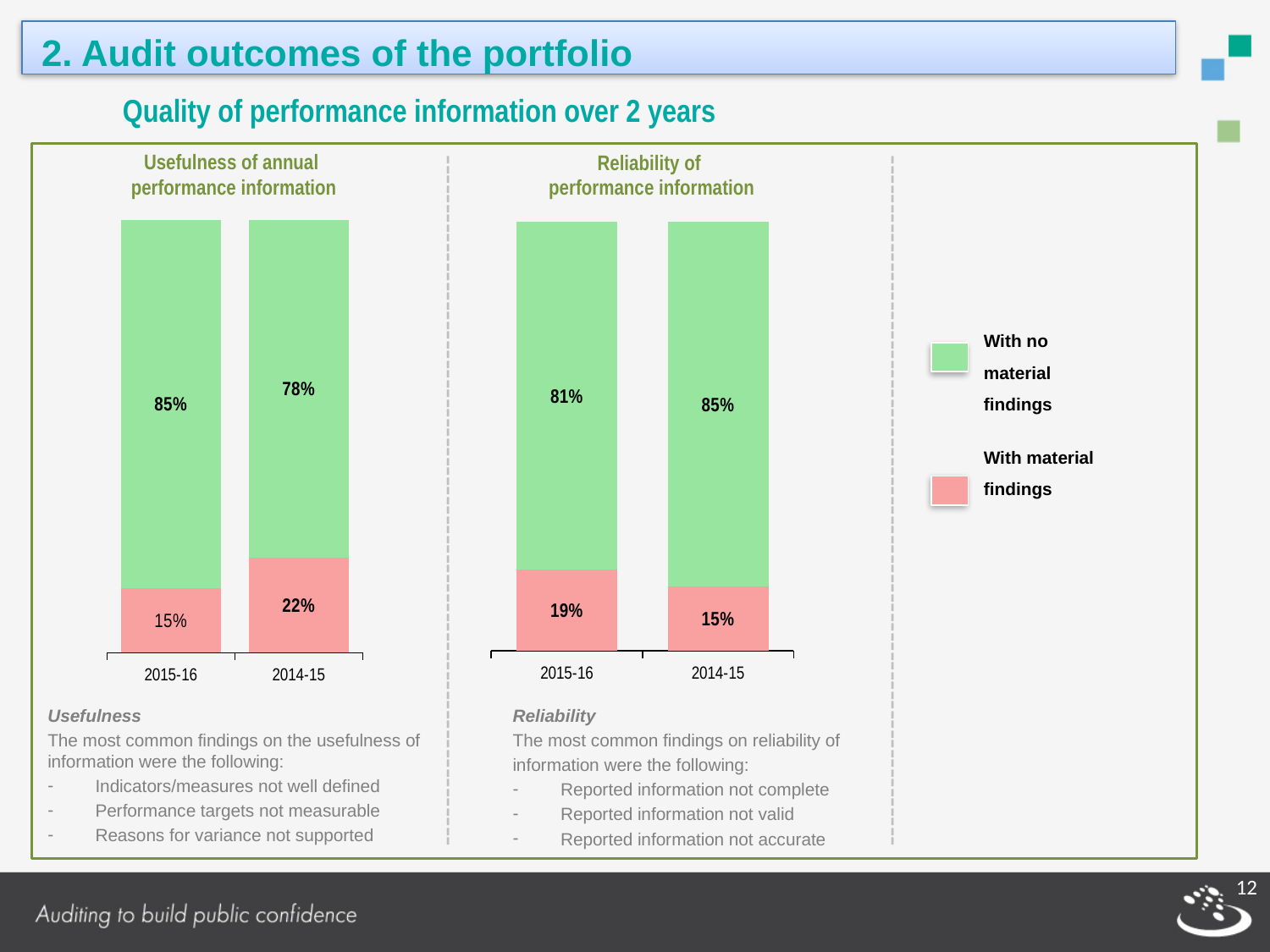
In the 'Usefulness of annual performance information' chart, what is the difference between the 'With no material findings' values for 2015-16 and 2014-15? 7% In the 'Reliability of performance information' chart, what is the difference between the 'With material findings' values for 2015-16 and 2014-15? 4% In the 'Usefulness of annual performance information' chart, which year has the higher share with material findings? 2014-15 In the 'Reliability of performance information' chart, what percentage had material findings in 2014-15? 15% In the 'Usefulness of annual performance information' chart, what percentage had no material findings in 2015-16? 85% In the 'Reliability of performance information' chart, what percentage had no material findings in 2015-16? 81% What kind of chart is the 'Reliability of performance information' chart? Stacked bar chart In the 'Reliability of performance information' chart, is the 'With no material findings' value larger in 2015-16 or 2014-15? 2014-15 How many series does the legend list? 2 In the 'Usefulness of annual performance information' chart, what percentage had material findings in 2014-15? 22% In the 'Usefulness of annual performance information' chart, what is the total of the 2015-16 stacked bar? 100% In the 'Reliability of performance information' chart, which year has the lower share with no material findings? 2015-16